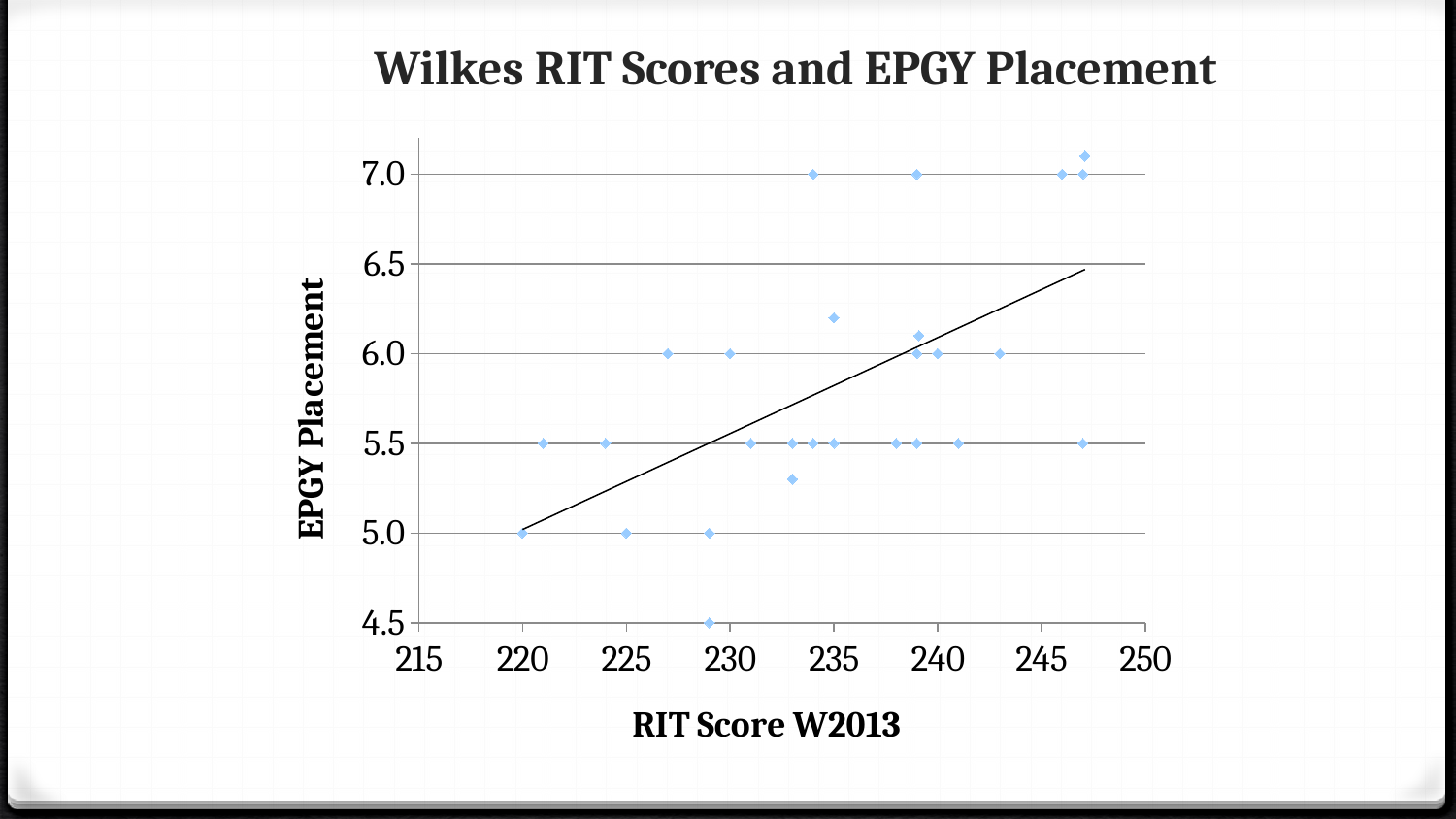
Which has the higher EPGY Placement: the point at RIT score 220 or the point at RIT score 246? 246 What kind of chart is shown on the slide? Scatter plot What is the lowest EPGY Placement value plotted on the chart? 4.5 Is the EPGY Placement for the point at RIT score 220 greater or less than 5.5? less Does the trend line rise or fall as RIT Score increases? Rises What is the title of the chart? Wilkes RIT Scores and EPGY Placement Is the trend line's value at RIT score 245 greater or less than 6.0? greater What is the highest value shown on the y axis? 7.0 What is the label of the x axis? RIT Score W2013 Is the lowest plotted point's EPGY Placement greater or less than 5.0? less